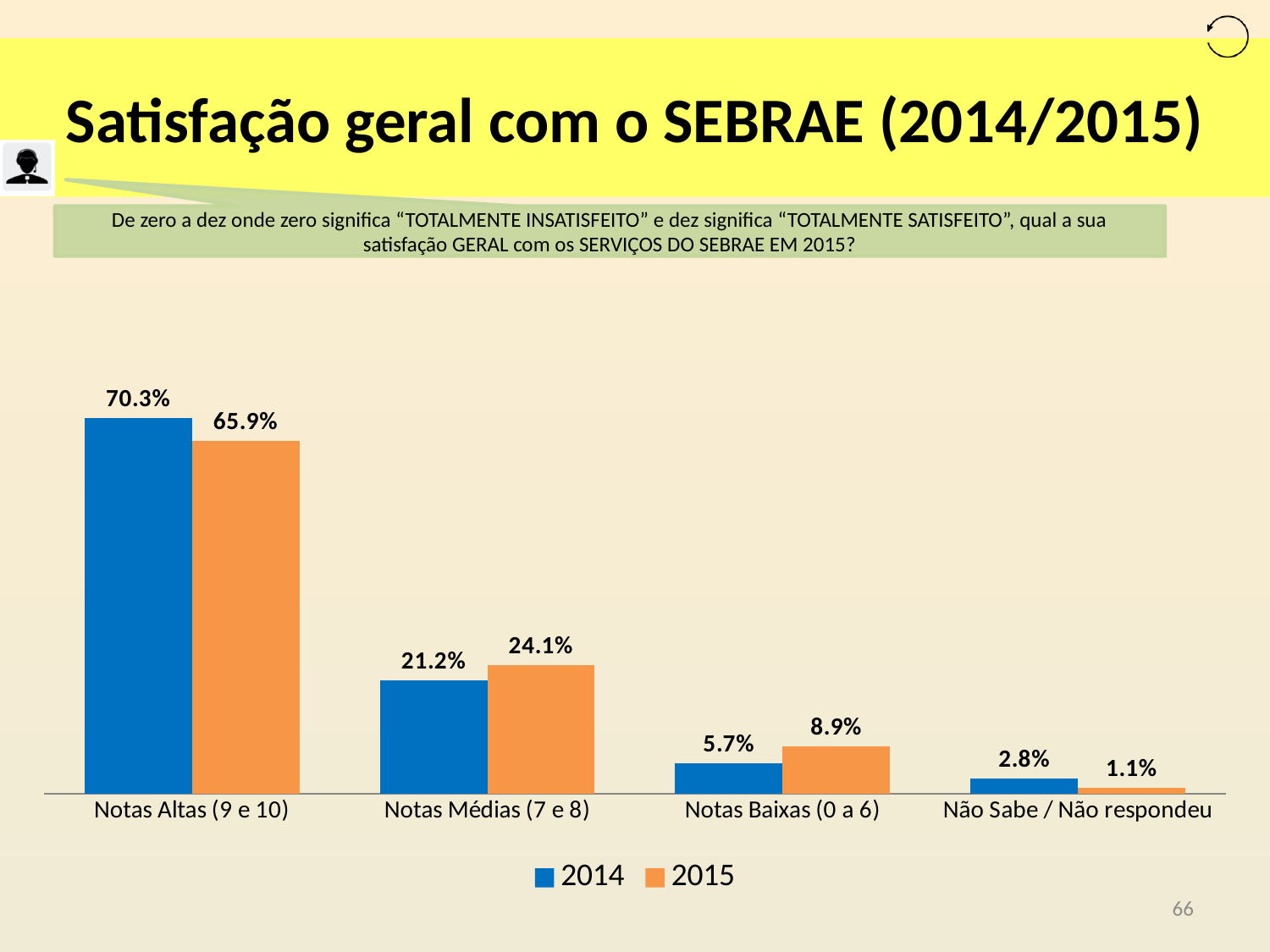
What is the value for Não Sabe / Não respondeu in 2015? 1.1% What is the difference between the 2014 and 2015 values for Notas Altas (9 e 10)? 4.4% What is the value for Notas Baixas (0 a 6) in 2014? 5.7% What is the value for Notas Médias (7 e 8) in 2015? 24.1% Which is larger for Notas Baixas (0 a 6): the 2014 value or the 2015 value? 2015 Which series is shown in orange in the legend? 2015 How many categories are shown on the x axis? 4 Which category has the lowest value for 2014? Não Sabe / Não respondeu What kind of chart is shown on the slide? Bar chart How many series does the legend list? 2 What is the value for Notas Altas (9 e 10) in 2014? 70.3% Which category has the highest value for 2015? Notas Altas (9 e 10)